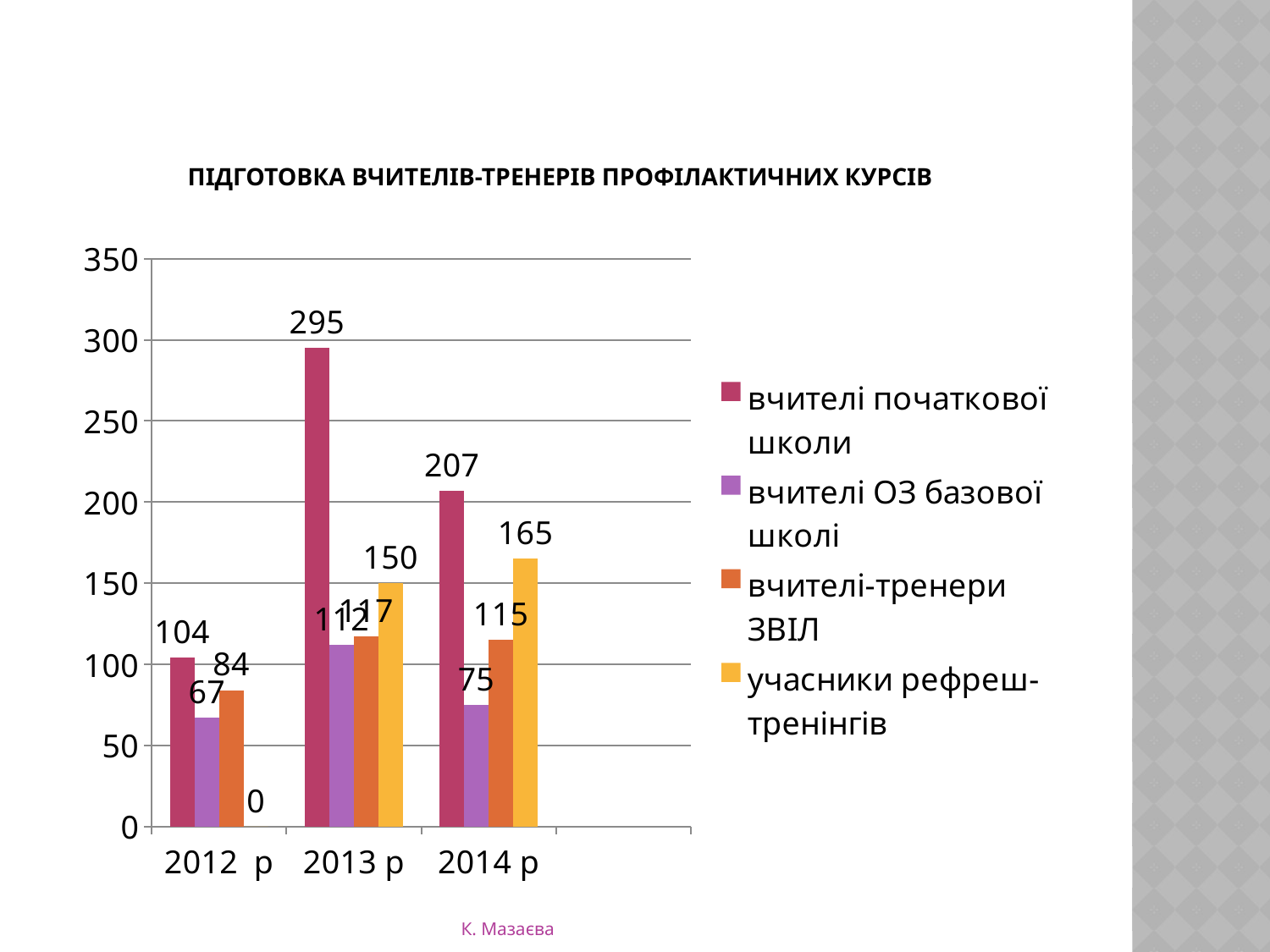
What is the value for вчителі ОЗ базової школі in 2012 р? 67 In which year is the value for вчителі-тренери ЗВІЛ lowest? 2012 р How many series does the legend list? 4 Is the value for вчителі ОЗ базової школі in 2013 р greater or less than 100? greater What is the value for учасники рефреш-тренінгів in 2012 р? 0 What is the difference between вчителі початкової школи in 2013 р and in 2014 р? 88 In which year is the value for вчителі початкової школи highest? 2013 р Which is larger in 2014 р: вчителі-тренери ЗВІЛ or учасники рефреш-тренінгів? учасники рефреш-тренінгів What is the value for учасники рефреш-тренінгів in 2014 р? 165 What is the value for вчителі початкової школи in 2013 р? 295 What type of chart is shown on the slide? bar chart How many year categories are shown on the x axis? 3